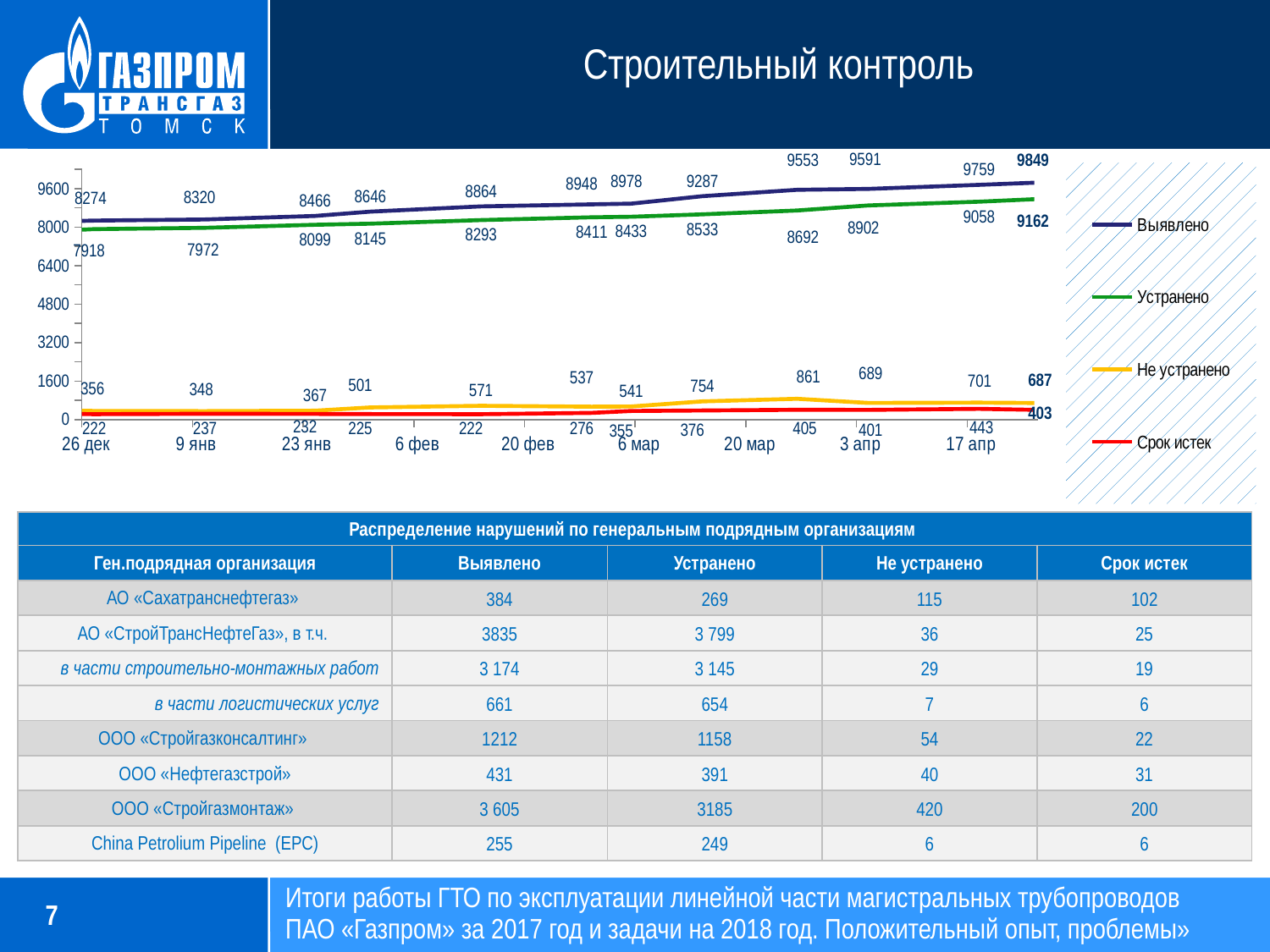
What is the last data label on the Устранено line? 9162 What is the last data label on the Выявлено line? 9849 Does the Выявлено line rise or fall from 26 дек to 17 апр? rises What is the highest value labelled on the Не устранено line? 861 At the last point, which is larger: Не устранено or Срок истек? Не устранено What is the lowest value labelled on the Срок истек line? 222 What is the difference between the last Выявлено value (9849) and the last Устранено value (9162)? 687 What type of chart is shown on the slide? line chart What is the highest value labelled on the Срок истек line? 443 What is the first data label on the Выявлено line (at 26 дек)? 8274 What colour is the Устранено line in the legend? green How many series does the chart legend list? 4